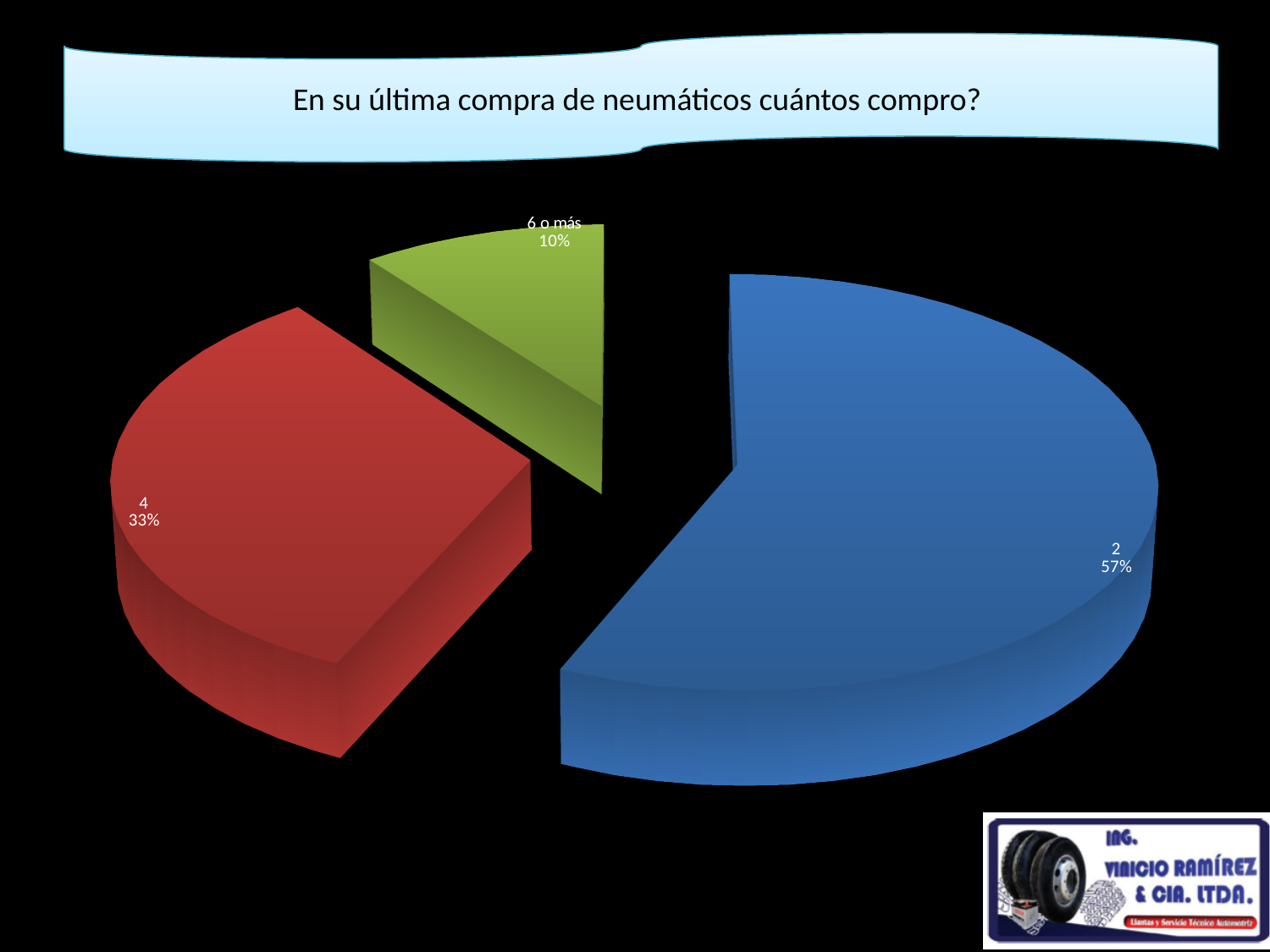
Which is larger, the share for "4" or the share for "6 o más"? 4 Which category has the smallest slice of the pie? 6 o más What is the difference in percentage points between the "2" slice and the "4" slice? 24 What is the difference in percentage points between the "4" slice and the "6 o más" slice? 23 What colour is the slice for the category "4"? Red What share of the pie does the category "4" have? 33% How many categories are shown in the pie chart? 3 What share of the pie does the category "2" have? 57% What is the title of the chart? En su última compra de neumáticos cuántos compro? What share of the pie does the category "6 o más" have? 10% Which category has the largest slice of the pie? 2 What kind of chart is shown on the slide? Pie chart